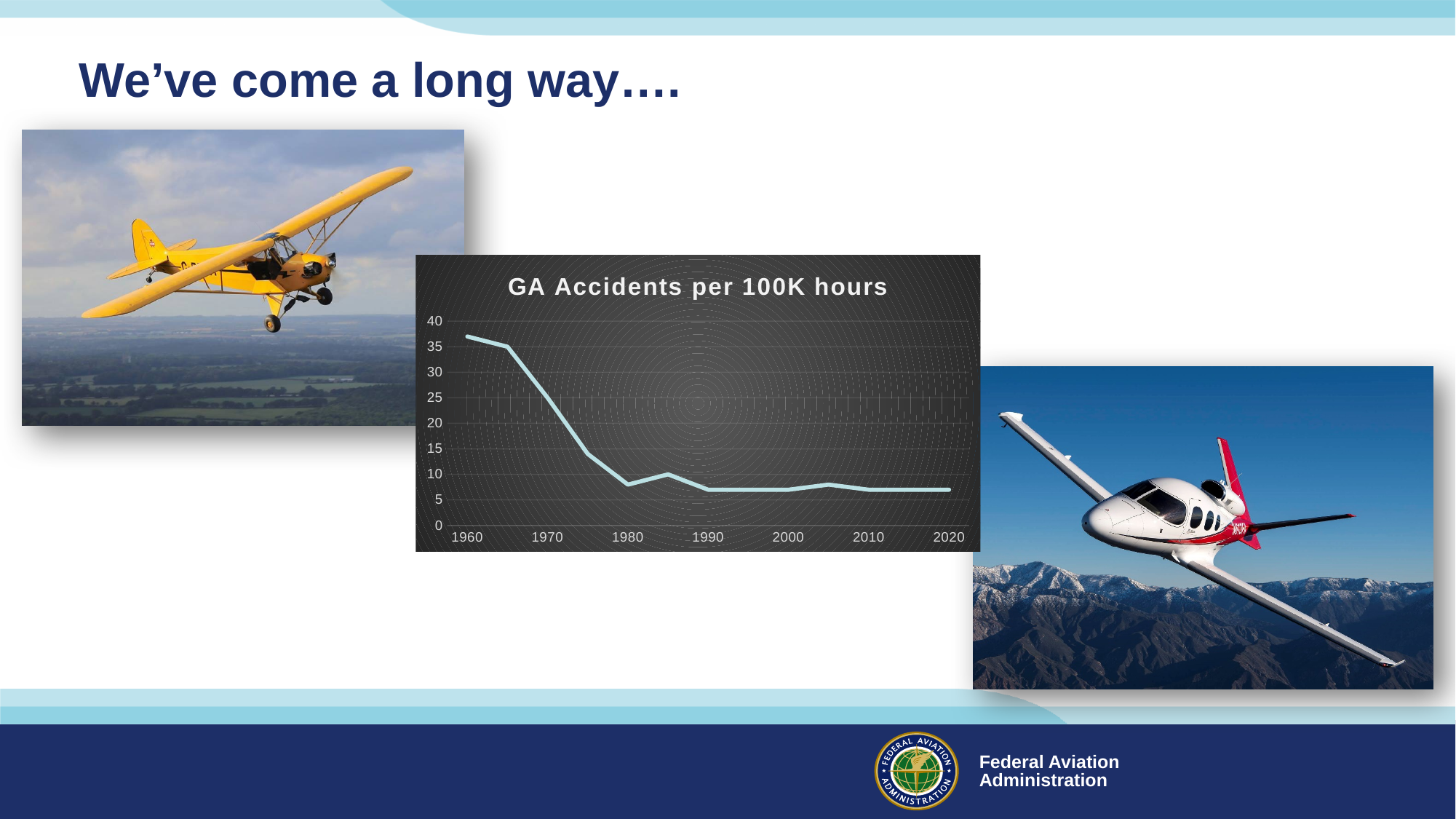
Is the value for 2020 greater or less than 10? less Which is larger, the value for 1960 or the value for 2020? 1960 What kind of chart is shown on the slide? line chart Which year has the highest value in the GA Accidents per 100K hours chart? 1960 What is the title of the chart? GA Accidents per 100K hours Is the value for 1980 greater or less than 10? less Is the value for 1960 greater or less than 30? greater Do the values in the GA Accidents per 100K hours chart rise or fall from 1960 to 2020? fall How many year labels are shown on the x axis of the chart? 7